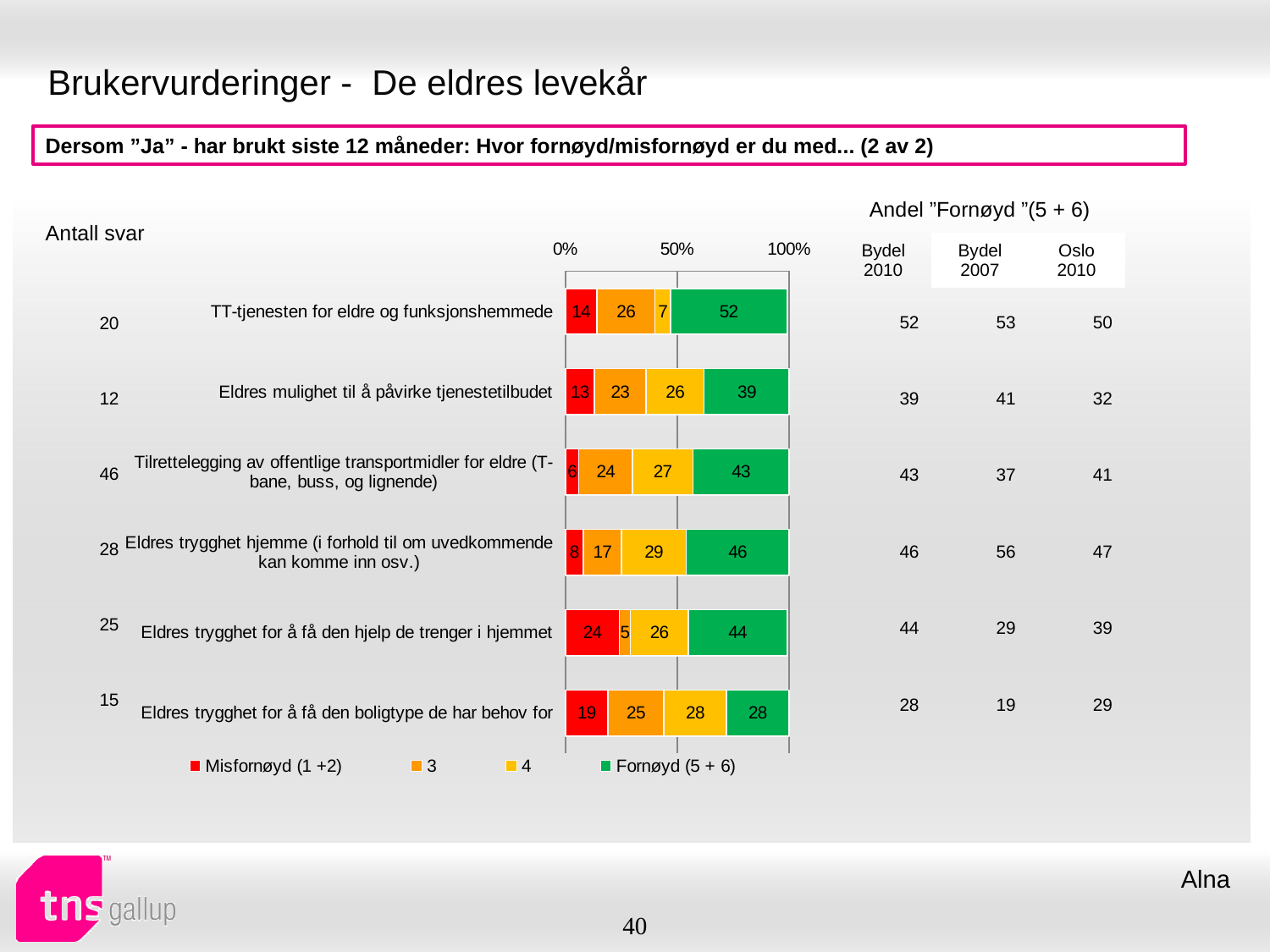
What is the total of the stacked bar for 'Eldres mulighet til å påvirke tjenestetilbudet'? 101 Which has a larger Misfornøyd (1 +2) value: 'Eldres trygghet for å få den boligtype de har behov for' or 'Tilrettelegging av offentlige transportmidler for eldre (T-bane, buss, og lignende)'? Eldres trygghet for å få den boligtype de har behov for Which category has the highest Fornøyd (5 + 6) value? TT-tjenesten for eldre og funksjonshemmede What kind of chart is shown on the slide? Stacked bar chart Which category has the lowest Fornøyd (5 + 6) value? Eldres trygghet for å få den boligtype de har behov for How many categories (statements) are plotted in the chart? 6 How many series does the chart legend list? 4 What is the difference between the Fornøyd (5 + 6) values for 'TT-tjenesten for eldre og funksjonshemmede' and 'Eldres mulighet til å påvirke tjenestetilbudet'? 13 What is the Misfornøyd (1 +2) value for 'Eldres trygghet for å få den hjelp de trenger i hjemmet'? 24 What is the Fornøyd (5 + 6) value for 'TT-tjenesten for eldre og funksjonshemmede'? 52 What colour represents the Fornøyd (5 + 6) series in the chart? Green What is the value of series '4' for 'Eldres trygghet hjemme (i forhold til om uvedkommende kan komme inn osv.)'? 29